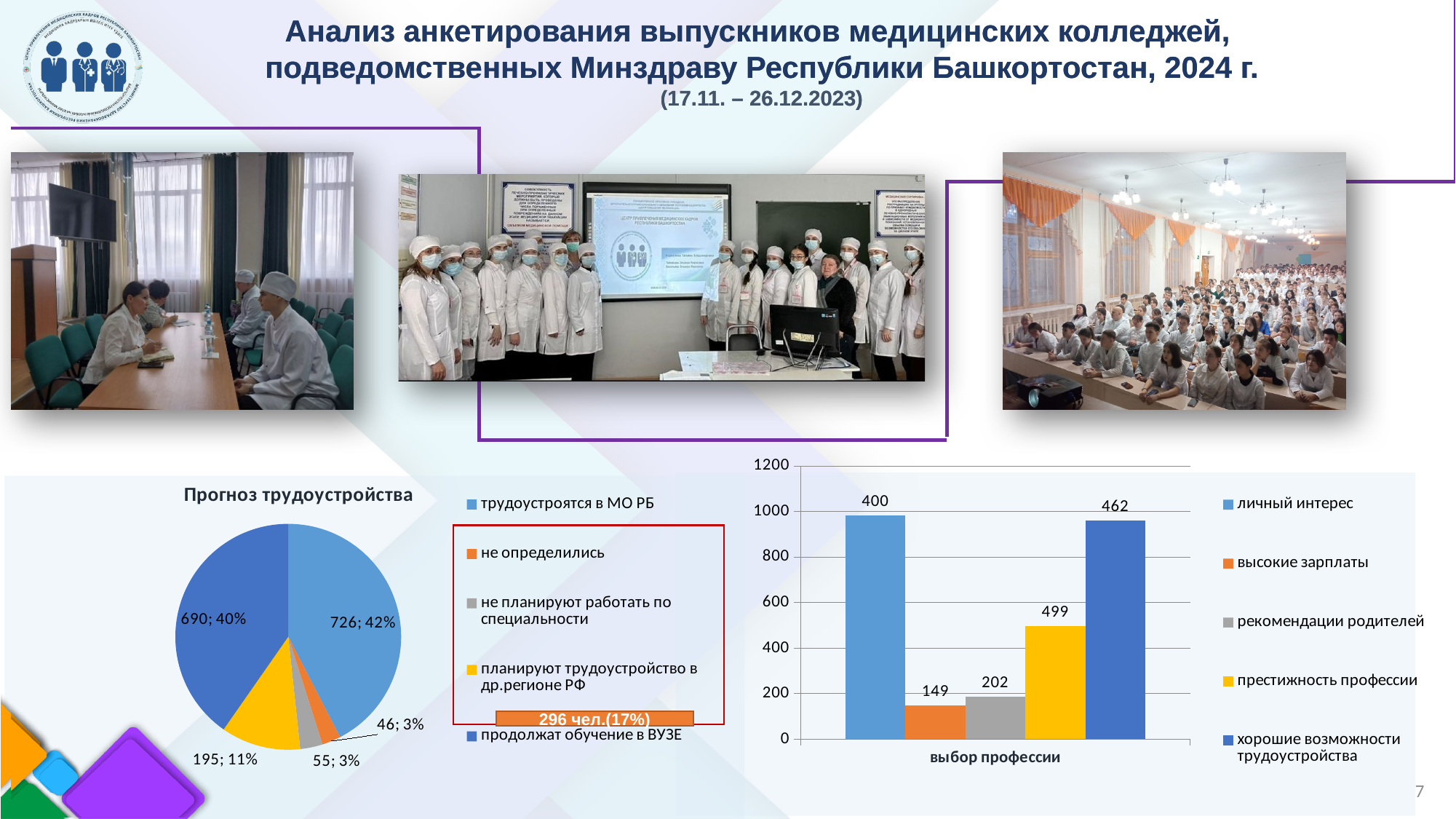
In the 'выбор профессии' bar chart, what is the value for 'рекомендации родителей'? 202 In the 'Прогноз трудоустройства' pie chart, what value is shown for 'трудоустроятся в МО РБ'? 726; 42% In the 'Прогноз трудоустройства' pie chart, what share of the pie is 'планируют трудоустройство в др.регионе РФ'? 11% In the 'Прогноз трудоустройства' pie chart, which category has the largest slice? трудоустроятся в МО РБ In the 'Прогноз трудоустройства' pie chart, what value is shown for 'продолжат обучение в ВУЗЕ'? 690; 40% In the 'выбор профессии' bar chart, what is the value for 'престижность профессии'? 499 What type of chart is the 'Прогноз трудоустройства' chart? pie chart In the 'Прогноз трудоустройства' pie chart, how many categories does the legend list? 5 In the 'выбор профессии' bar chart, which is larger: 'личный интерес' or 'высокие зарплаты'? личный интерес In the 'выбор профессии' bar chart, which category has the lowest value? высокие зарплаты What type of chart is the 'выбор профессии' chart? bar chart In the 'выбор профессии' bar chart, what is the difference between 'престижность профессии' and 'хорошие возможности трудоустройства'? 37